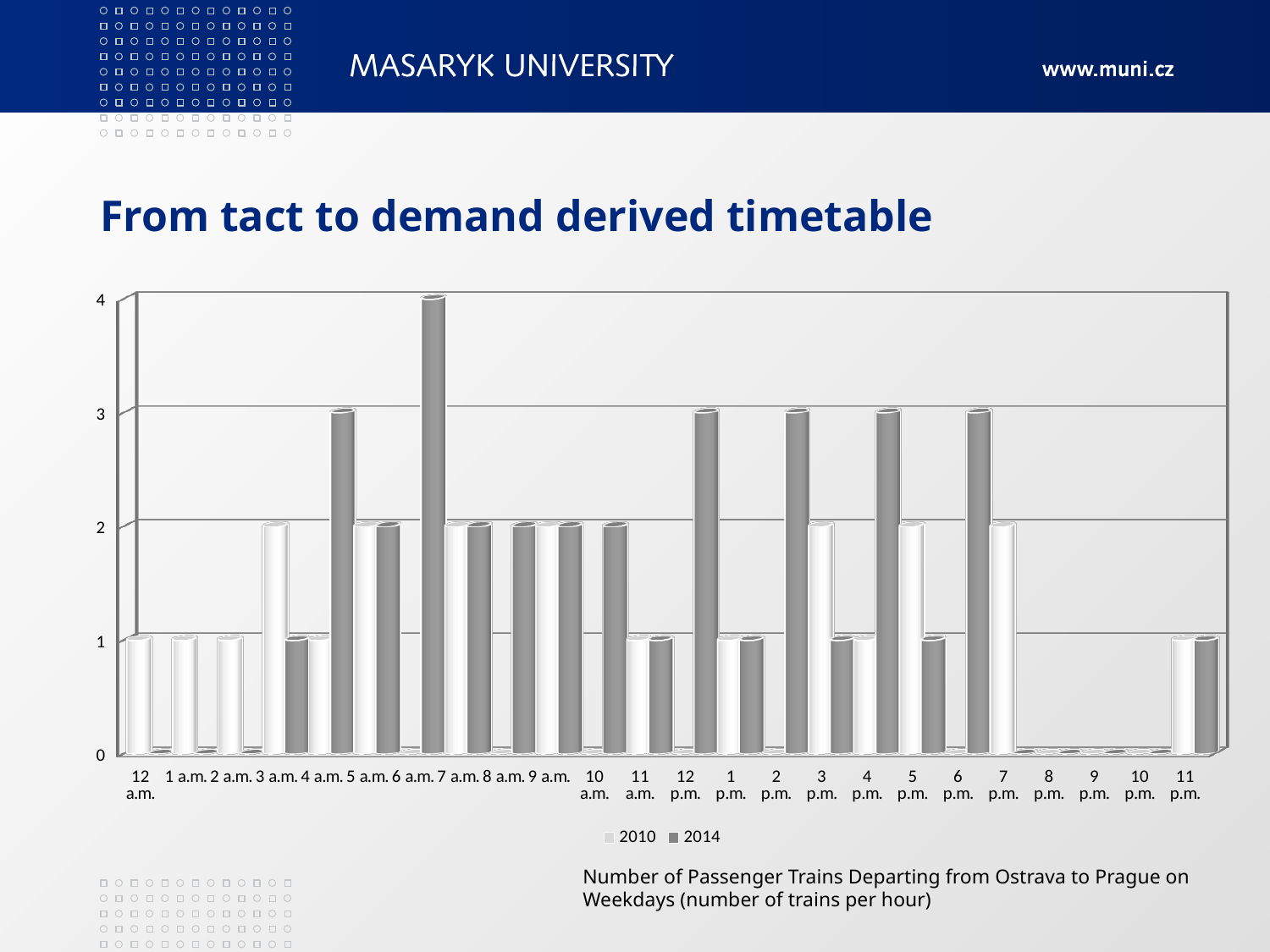
At 4 a.m., which series has the larger value, 2010 or 2014? 2014 What is the 2014 value at 6 a.m.? 4 Which two years are listed in the legend? 2010 and 2014 At which hour does the 2014 series reach its highest value? 6 a.m. Is the 2014 value at 6 a.m. greater or less than 3? greater What is the difference between the 2014 and 2010 values at 4 a.m.? 2 How many series does the legend list? 2 How many hour categories are shown on the x axis? 24 What is the 2010 value at 12 a.m.? 1 What is the 2014 value at 4 a.m.? 3 What is the 2010 value at 3 a.m.? 2 What kind of chart is shown on the slide? Bar chart